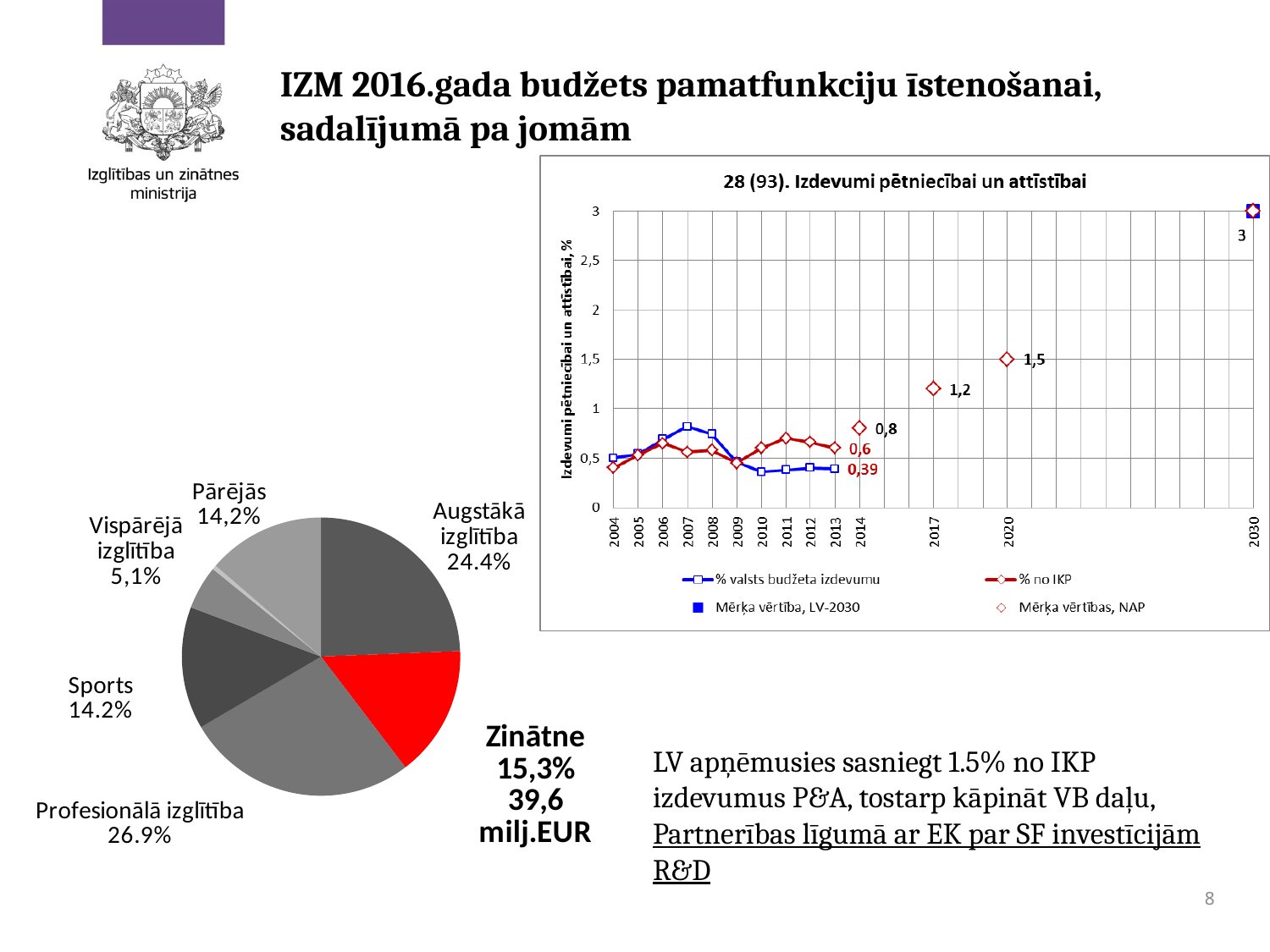
In the chart '28 (93). Izdevumi pētniecībai un attīstībai', what is the NAP target value for 2017? 1,2 In the chart '28 (93). Izdevumi pētniecībai un attīstībai', what is the NAP target value (Mērķa vērtības, NAP) for 2020? 1,5 In the pie chart on the left, which area has the largest share? Profesionālā izglītība How many slices does the pie chart on the left have? 7 In the pie chart on the left, by how many percentage points does Profesionālā izglītība exceed Augstākā izglītība? 2.5 percentage points How many series does the legend of the chart '28 (93). Izdevumi pētniecībai un attīstībai' list? 4 In the chart '28 (93). Izdevumi pētniecībai un attīstībai', what is the LV-2030 target value for 2030? 3 In the chart '28 (93). Izdevumi pētniecībai un attīstībai', is the value of '% valsts budžeta izdevumu' in 2007 greater or less than 0,5? greater In the pie chart on the left, what share of the budget goes to Profesionālā izglītība? 26.9% What kind of chart is the chart titled '28 (93). Izdevumi pētniecībai un attīstībai'? line chart In the pie chart on the left, what amount in milj.EUR is shown for Zinātne? 39,6 milj.EUR